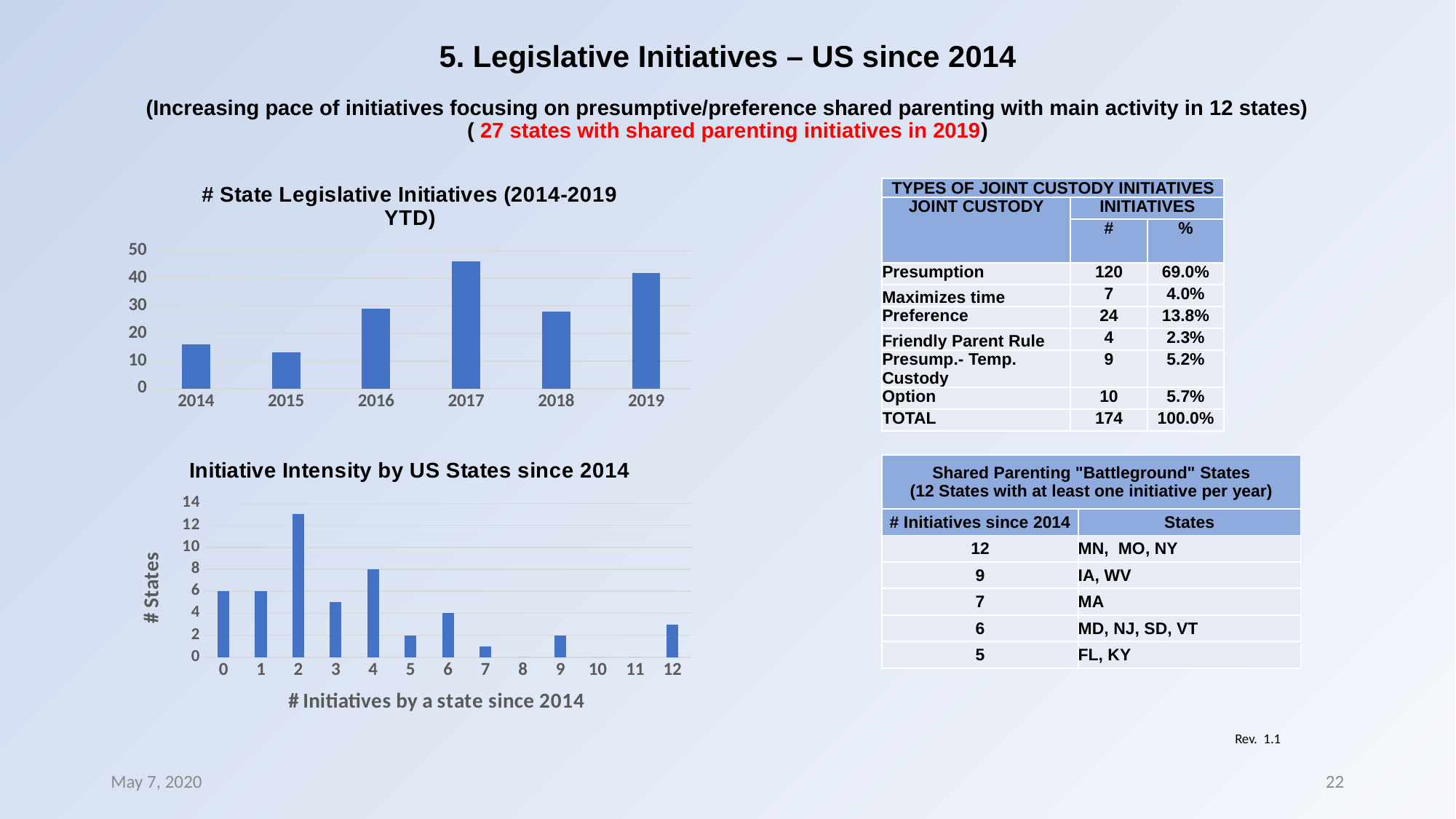
In the '# State Legislative Initiatives (2014-2019 YTD)' chart, which year has more initiatives, 2018 or 2019? 2019 What kind of chart is the '# State Legislative Initiatives (2014-2019 YTD)' chart? bar chart What is the y-axis label of the 'Initiative Intensity by US States since 2014' chart? # States In the '# State Legislative Initiatives (2014-2019 YTD)' chart, do the values rise or fall from 2015 to 2017? rise In the '# State Legislative Initiatives (2014-2019 YTD)' chart, is the value for 2017 greater or less than 40? greater In the '# State Legislative Initiatives (2014-2019 YTD)' chart, which year has the highest number of initiatives? 2017 In the 'Initiative Intensity by US States since 2014' chart, how many states have 4 initiatives? 8 In the '# State Legislative Initiatives (2014-2019 YTD)' chart, how many years are shown on the x axis? 6 In the 'Initiative Intensity by US States since 2014' chart, is the value for 2 initiatives greater or less than 12? greater In the '# State Legislative Initiatives (2014-2019 YTD)' chart, which year has the lowest number of initiatives? 2015 In the 'Initiative Intensity by US States since 2014' chart, which number of initiatives has the highest number of states? 2 In the '# State Legislative Initiatives (2014-2019 YTD)' chart, is the value for 2015 greater or less than 20? less